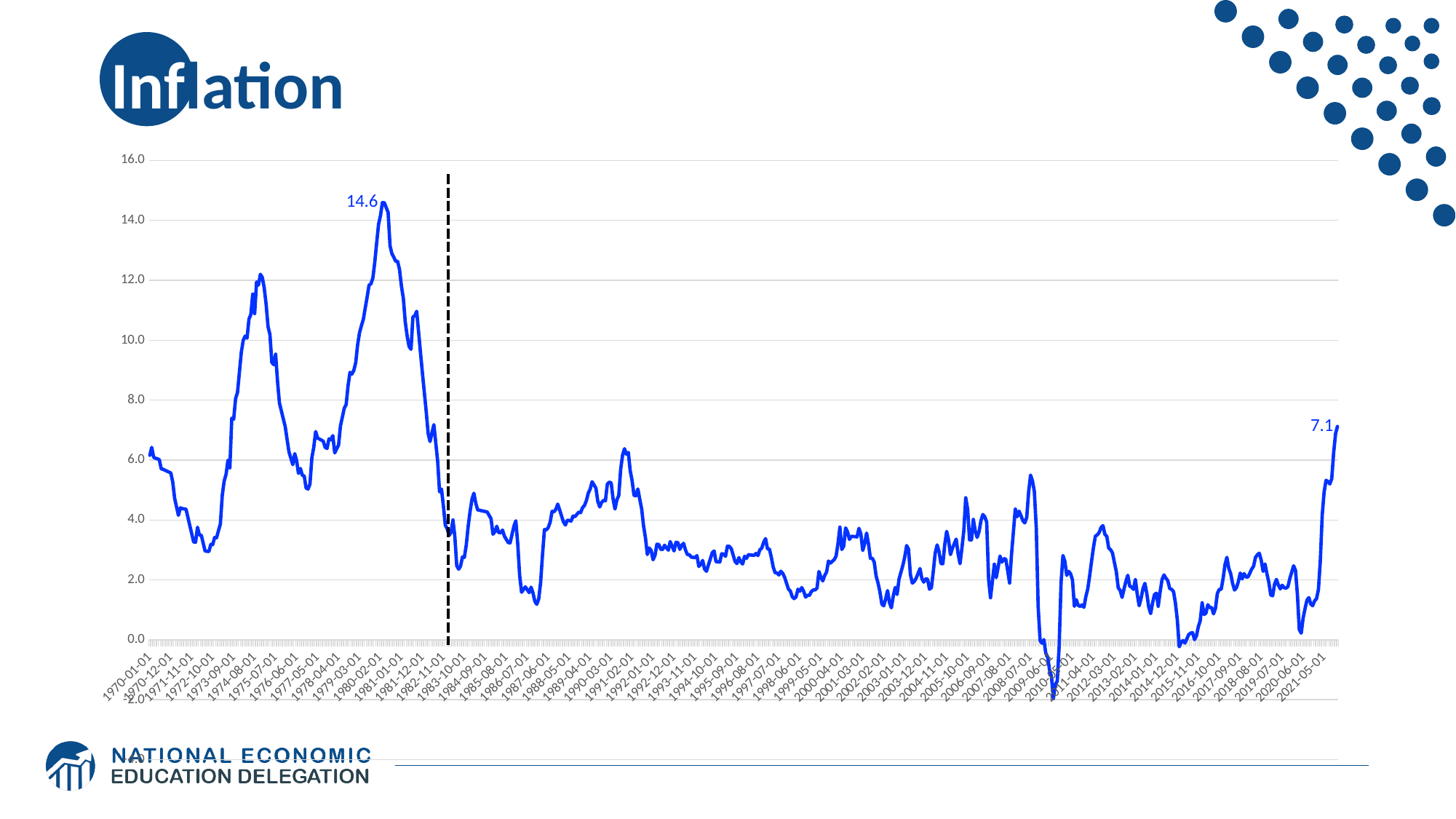
Which is larger: the labelled value around 1980 or the labelled value around 2021? the value around 1980 (14.6) What colour is the plotted line? blue What kind of chart is shown on the slide? line chart What value is labelled at the right-hand end of the line, around 2021? 7.1 Does the line rise or fall over the final stretch from 2020 to 2021? rises What is the highest value labelled on the line? 14.6 What is the difference between the labelled peak value of 14.6 and the labelled end value of 7.1? 7.5 Is the value at the start of the series, around 1970-01-01, greater or less than 4.0? greater Does the line rise or fall between the 1980 peak and the dashed vertical line around 1983? falls Is the peak value around 1974-1975 greater or less than 10.0? greater What is the title of the slide containing the chart? Inflation Is the value around 2015-11-01 greater or less than 2.0? less